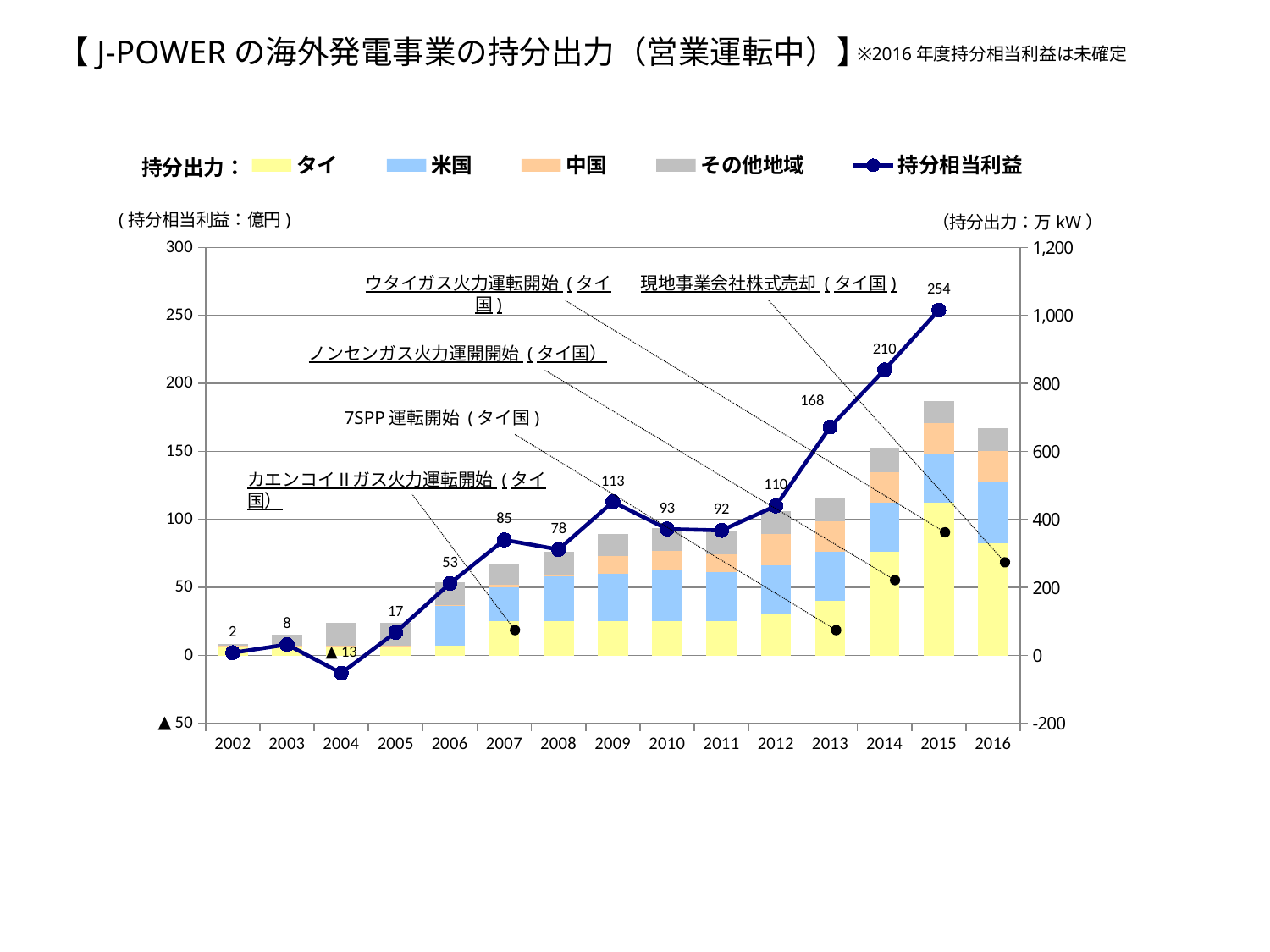
Is the total 持分出力 stacked bar for 2015 greater or less than 600 on the right axis? greater How many years are shown on the x axis? 15 In which year is the 持分相当利益 line at its lowest labelled value? 2004 In which year is the 持分相当利益 line at its highest labelled value? 2015 How many series does the legend list? 5 What is the 持分相当利益 value for 2015? 254 What kind of chart is this? Combination of a stacked bar chart and a line chart What is the 持分相当利益 value for 2004? ▲13 What is the 持分相当利益 value for 2009? 113 Does the 持分相当利益 line rise or fall from 2012 to 2015? rise What is the difference between the 持分相当利益 values for 2015 and 2014? 44 Which year has the larger 持分相当利益 value, 2010 or 2012? 2012